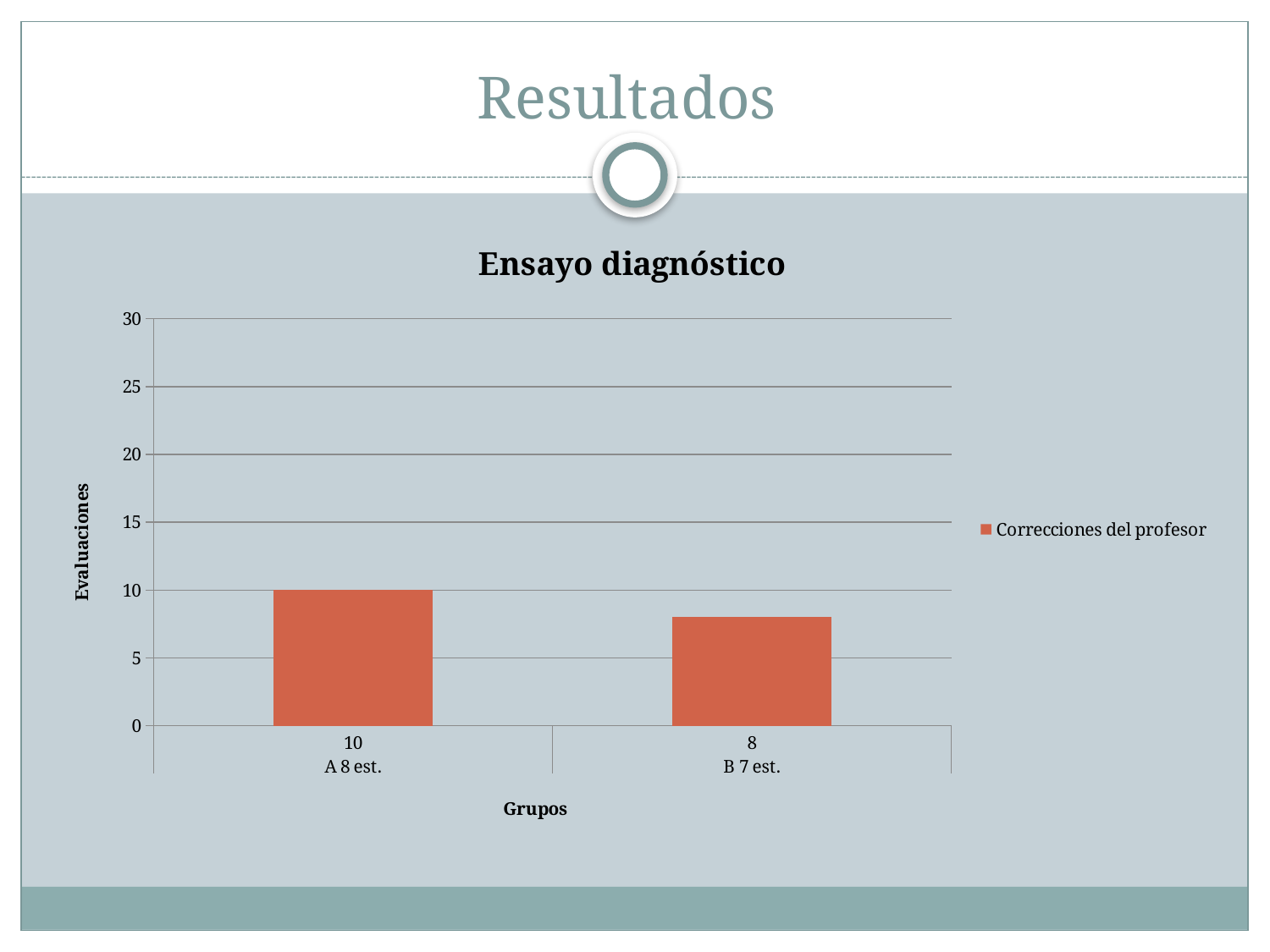
Which group has the lowest value of Correcciones del profesor? B 7 est. What is the name of the series shown in the legend? Correcciones del profesor How many series does the legend list? 1 What is the difference between the values for group A 8 est. and group B 7 est.? 2 Is the value for group B 7 est. greater or less than 10? less What is the value of Correcciones del profesor for group A 8 est.? 10 Do the values rise or fall from group A 8 est. to group B 7 est.? fall Which group has the highest value of Correcciones del profesor? A 8 est. What type of chart is shown on the slide? bar chart What is the value of Correcciones del profesor for group B 7 est.? 8 How many groups (bars) are plotted in the chart? 2 What is the title of the chart? Ensayo diagnóstico